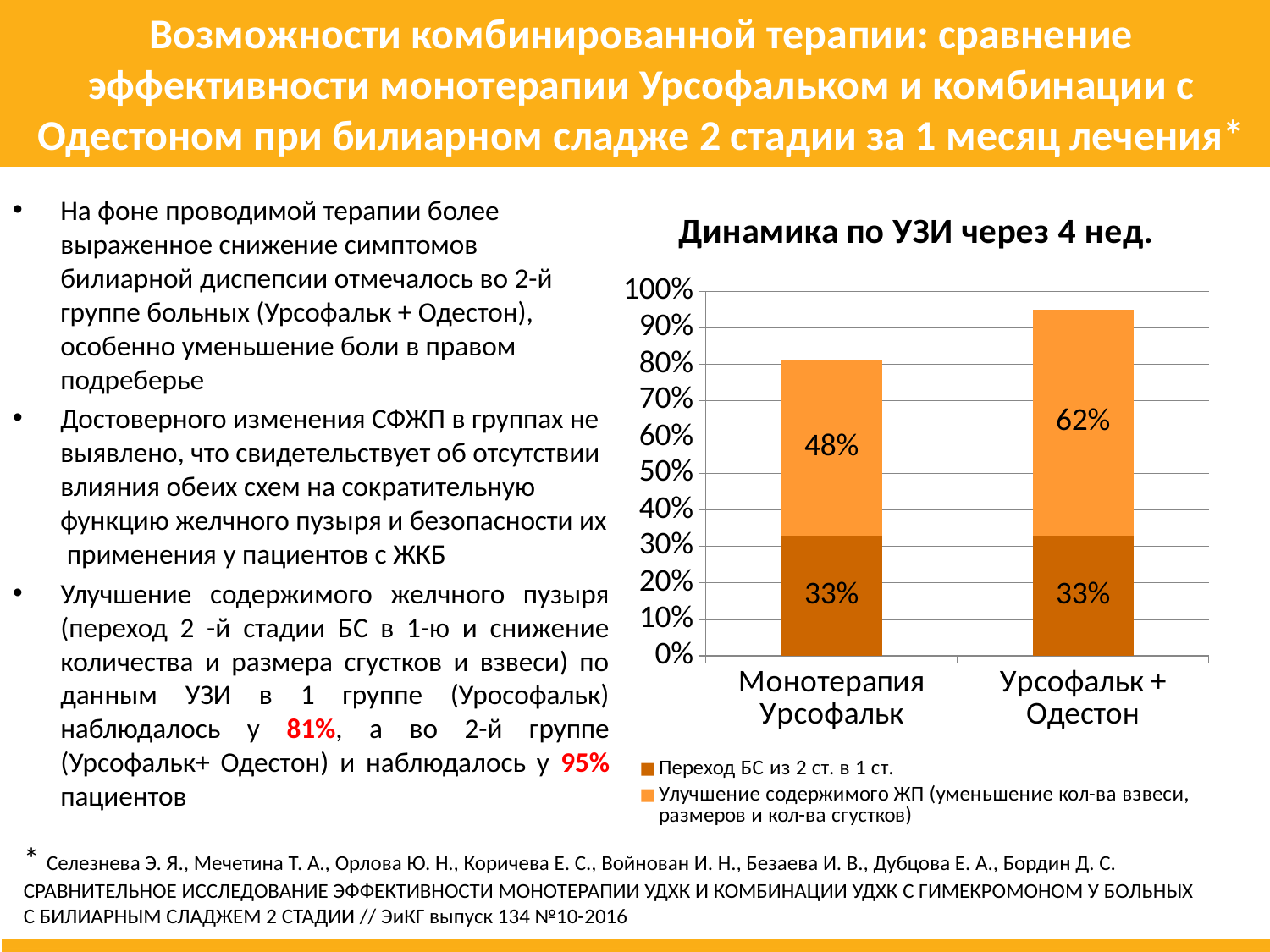
What type of chart is shown on the slide? stacked bar chart What is the total of the stacked bar for "Урсофальк + Одестон"? 95% What is the value of "Улучшение содержимого ЖП" for "Урсофальк + Одестон"? 62% What is the title of the chart? Динамика по УЗИ через 4 нед. Is the total stacked bar for "Урсофальк + Одестон" greater or less than 90%? greater Which category has the higher value for "Улучшение содержимого ЖП"? Урсофальк + Одестон What is the difference between the "Улучшение содержимого ЖП" values for "Урсофальк + Одестон" and "Монотерапия Урсофальк"? 14% How many series does the chart legend list? 2 How many categories are shown on the x axis of the chart? 2 What is the value of "Улучшение содержимого ЖП" for "Монотерапия Урсофальк"? 48% What is the total of the stacked bar for "Монотерапия Урсофальк"? 81% What is the value of "Переход БС из 2 ст. в 1 ст." for "Монотерапия Урсофальк"? 33%